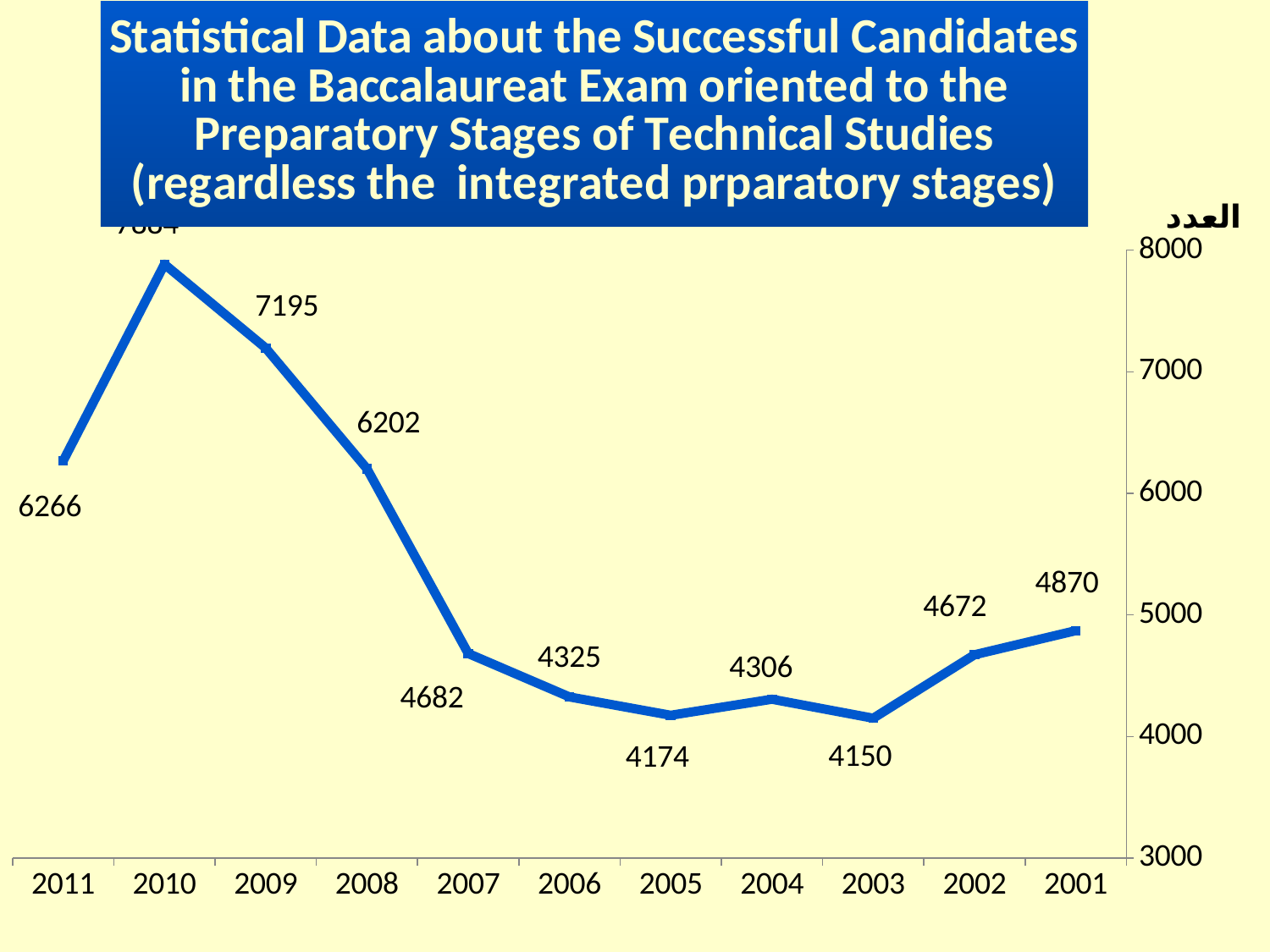
What is the value for 2001? 4870 What kind of chart is shown on the slide? line chart What is the difference between the values for 2001 and 2002? 198 What is the value for 2005? 4174 Which year has the lowest value? 2003 How many years are plotted on the x axis? 11 What is the value for 2011? 6266 What is the difference between the values for 2009 and 2008? 993 What is the value for 2009? 7195 Which year has the highest value? 2010 Is the value for 2010 greater or less than 7000? greater Which is larger, the value for 2007 or the value for 2002? 2007